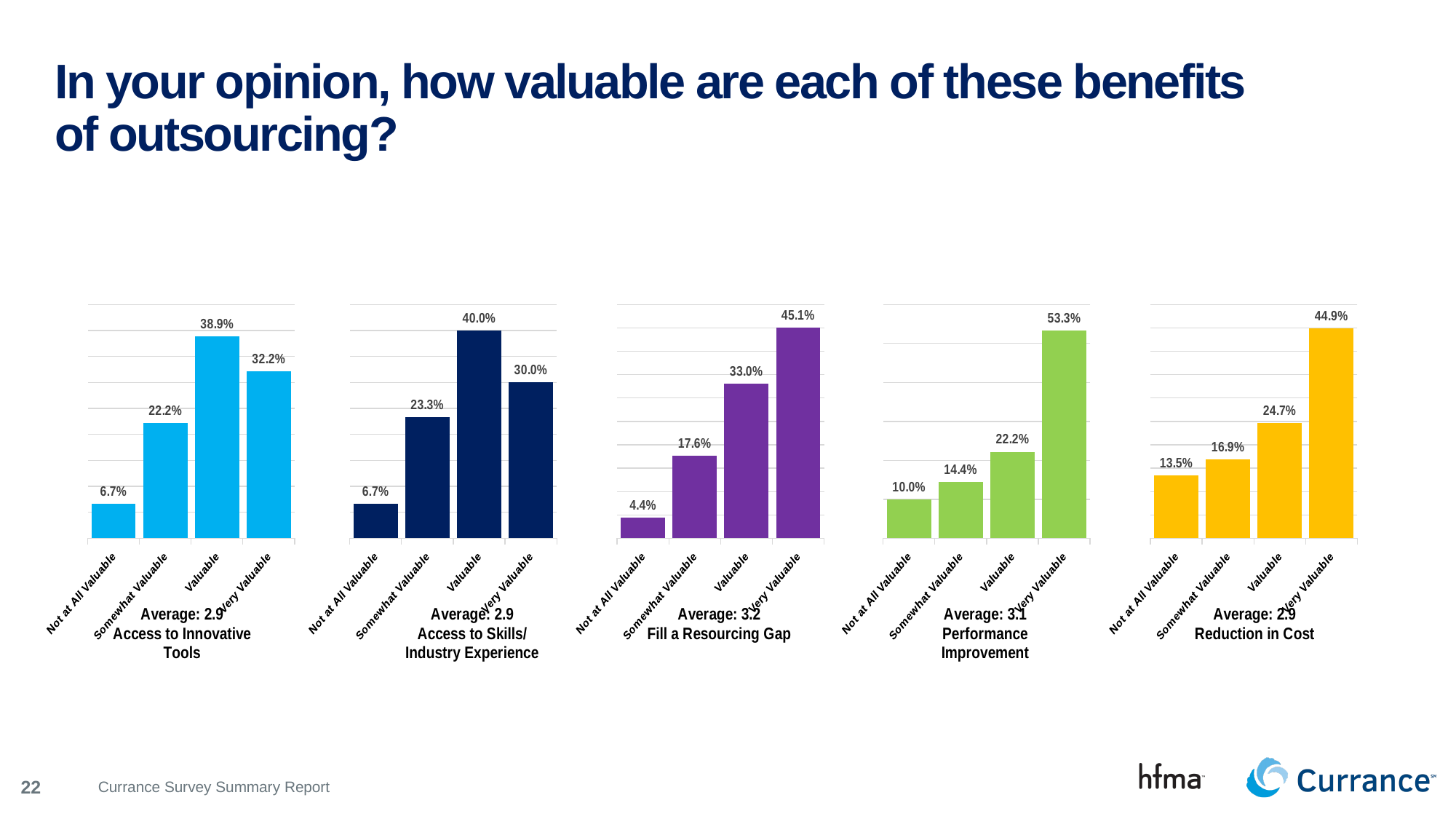
What average score is shown for the 'Fill a Resourcing Gap' chart? 3.2 In the 'Performance Improvement' chart, which category has the highest value? Very Valuable How many charts are shown on the slide? 5 In the 'Fill a Resourcing Gap' chart, what is the value for 'Very Valuable'? 45.1% In the 'Reduction in Cost' chart, which category has the lowest value? Not at All Valuable In the 'Access to Innovative Tools' chart, which is larger: 'Valuable' or 'Very Valuable'? Valuable In the 'Access to Skills/Industry Experience' chart, what is the value for 'Somewhat Valuable'? 23.3% In the 'Fill a Resourcing Gap' chart, what is the difference between 'Very Valuable' and 'Valuable'? 12.1% In the 'Access to Innovative Tools' chart, what percentage of respondents rated it 'Valuable'? 38.9% How many categories are shown on the x axis of the 'Performance Improvement' chart? 4 In the 'Performance Improvement' chart, do the values rise or fall from 'Not at All Valuable' to 'Very Valuable'? Rise What kind of chart is the 'Reduction in Cost' chart? Bar chart